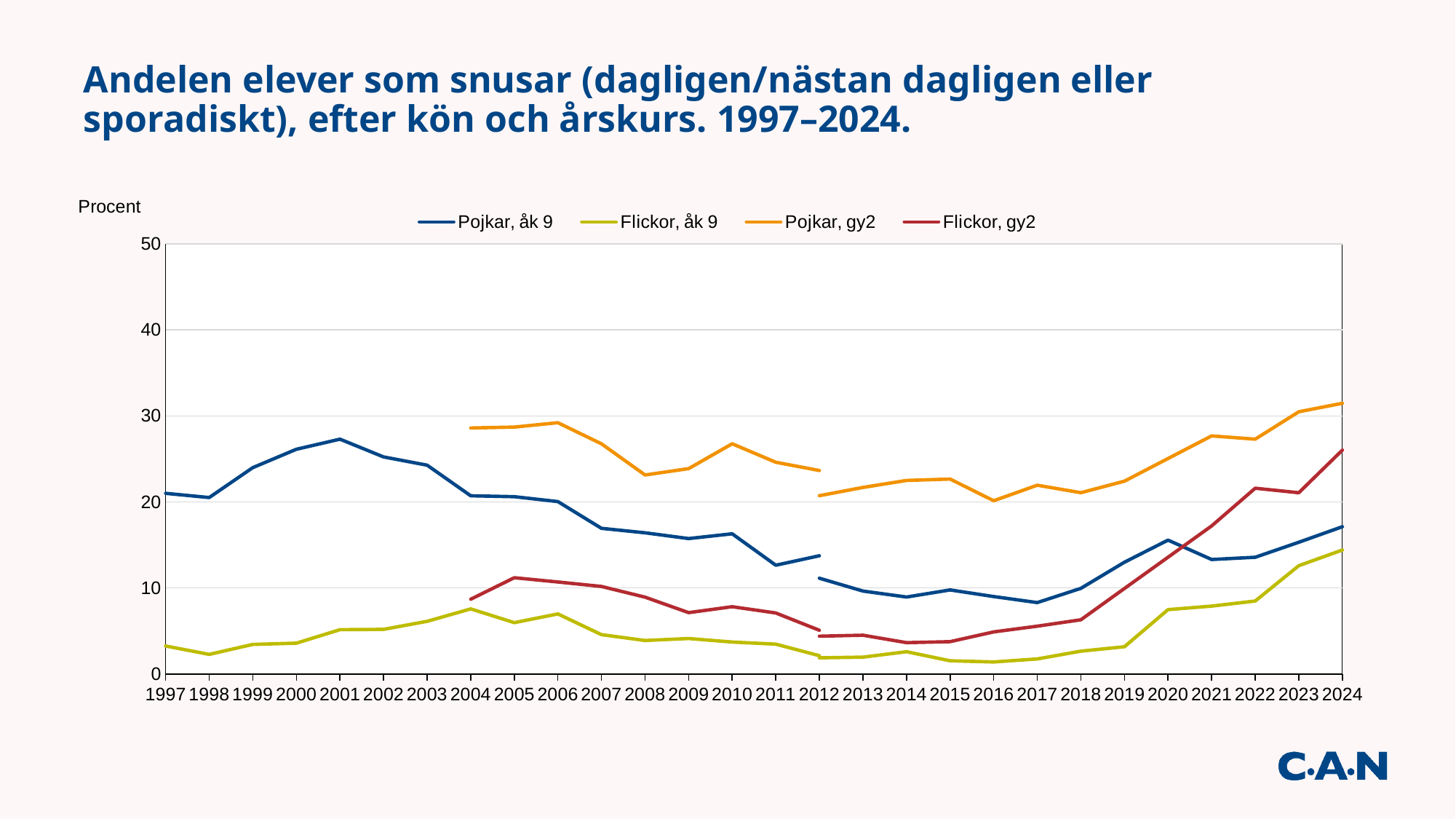
What kind of chart is shown on the slide? line chart How many series does the legend list? 4 In which year do the Pojkar, gy2 and Flickor, gy2 series first appear on the chart? 2004 What are the four series listed in the legend? Pojkar, åk 9; Flickor, åk 9; Pojkar, gy2; Flickor, gy2 Is the value for Flickor, åk 9 in 2016 greater or less than 5? less Is the value for Pojkar, åk 9 in 2001 greater or less than 20? greater Which series has the highest value in 2024? Pojkar, gy2 In 2024, which is higher: Pojkar, åk 9 or Flickor, gy2? Flickor, gy2 Does the Pojkar, åk 9 series rise or fall between 2017 and 2024? rise Which series has the lowest value in 2024? Flickor, åk 9 Is the value for Pojkar, gy2 in 2024 greater or less than 30? greater